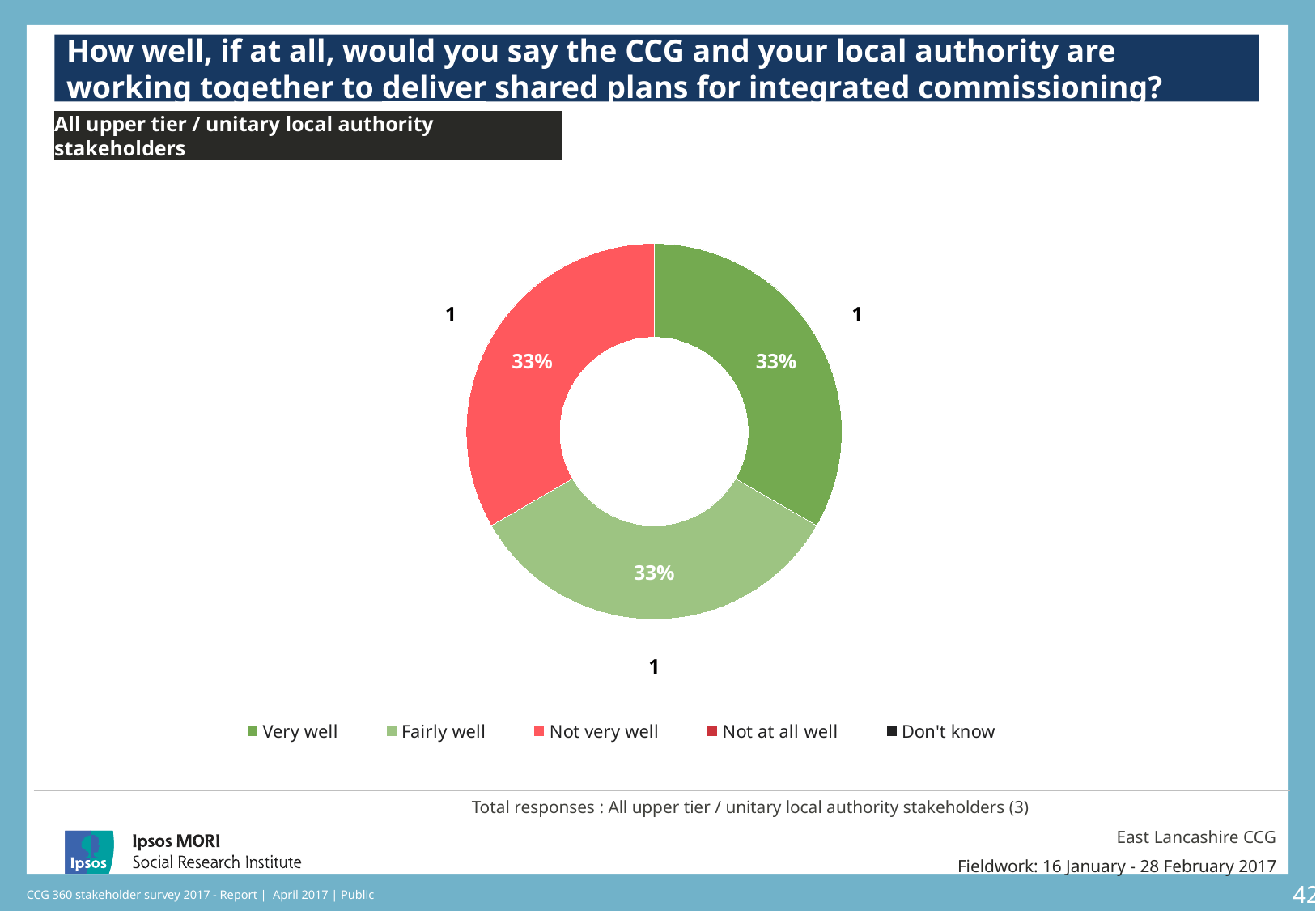
What percentage of respondents answered 'Not very well'? 33% What percentage of respondents answered 'Fairly well'? 33% What percentage of respondents answered 'Very well'? 33% How many slices are shown in the chart? 3 How many entries does the legend list? 5 What is the difference in percentage points between 'Very well' and 'Not very well'? 0 How many respondents answered 'Not very well'? 1 What kind of chart is shown on the slide? Pie chart (donut) How many respondents answered 'Very well'? 1 Which stakeholder group does the chart cover? All upper tier / unitary local authority stakeholders What is the total number of responses shown for the chart? 3 Which colour represents 'Not very well' in the chart? Red